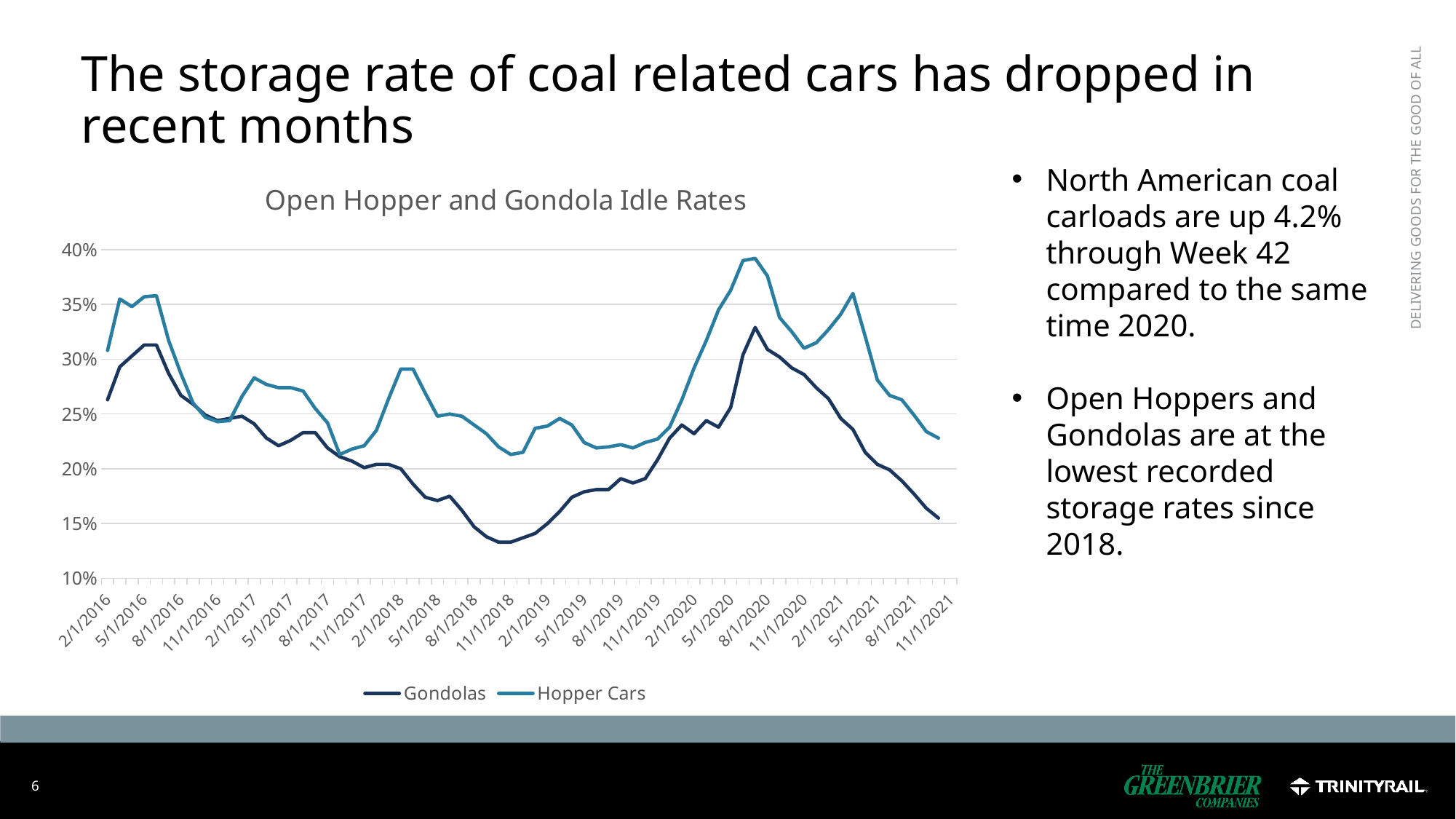
Is the Gondolas value at 11/1/2018 greater or less than 15%? less Which series reaches the lowest value anywhere on the chart? Gondolas Which series is drawn in the lighter blue line? Hopper Cars Which series reaches the highest value anywhere on the chart? Hopper Cars What is the title of the chart? Open Hopper and Gondola Idle Rates Is the Gondolas value at 8/1/2020 greater or less than 30%? greater How many series does the chart legend list? 2 Between 8/1/2020 and 11/1/2021, does the Gondolas line rise or fall? fall At 11/1/2018, which series has the higher idle rate, Gondolas or Hopper Cars? Hopper Cars Is the Hopper Cars value at 8/1/2020 greater or less than 35%? greater What kind of chart is shown on the slide? Line chart